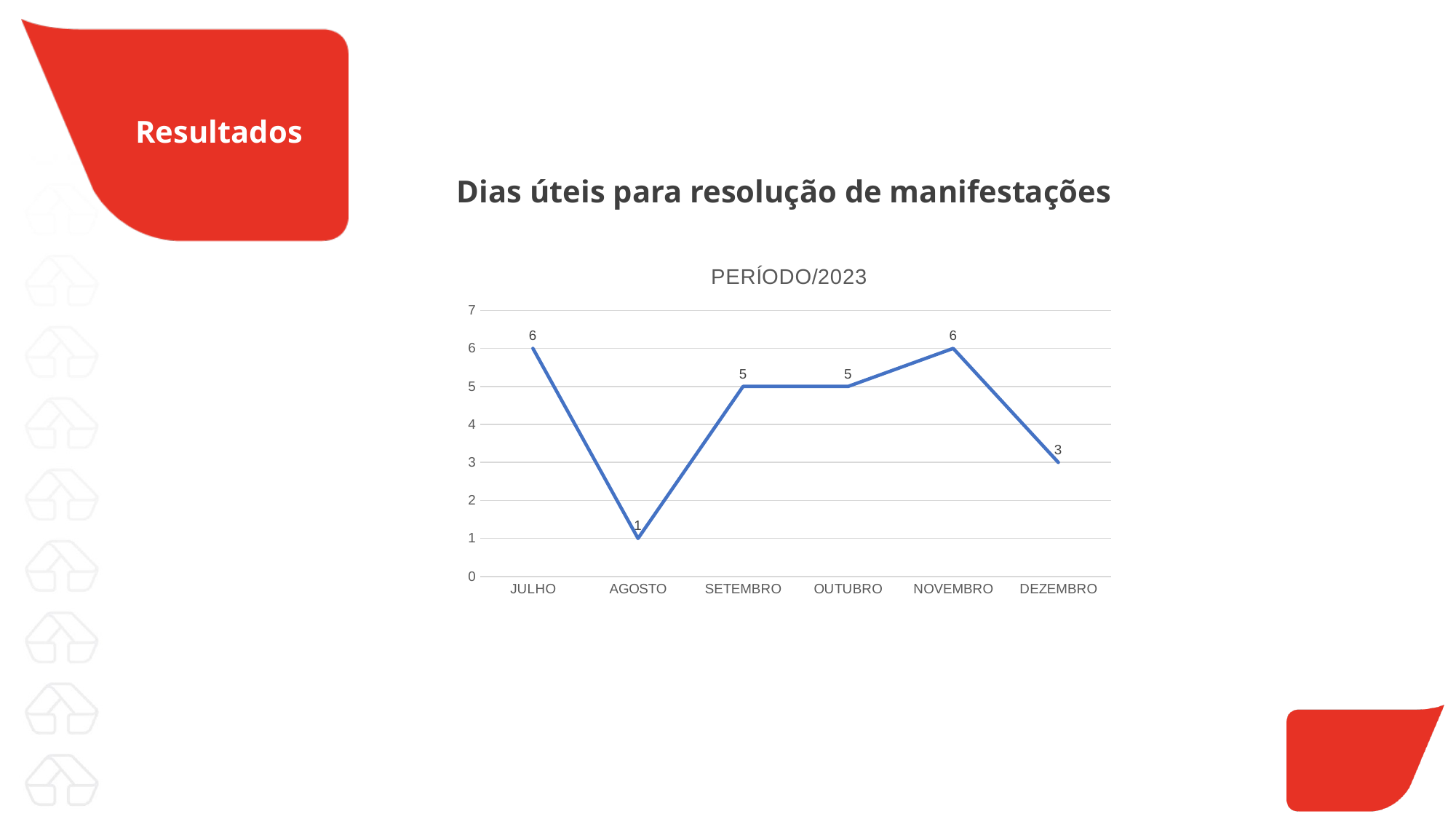
What is the highest value shown on the vertical axis? 7 What is the value for SETEMBRO? 5 Which month has the lowest value? AGOSTO Which is larger, the value for OUTUBRO or the value for DEZEMBRO? OUTUBRO Do the values rise or fall from NOVEMBRO to DEZEMBRO? fall What is the difference between the values for JULHO and AGOSTO? 5 What is the value for AGOSTO? 1 What is the chart's title? PERÍODO/2023 What is the difference between the values for NOVEMBRO and DEZEMBRO? 3 What is the value for DEZEMBRO? 3 How many months are plotted on the chart? 6 What kind of chart is shown? line chart